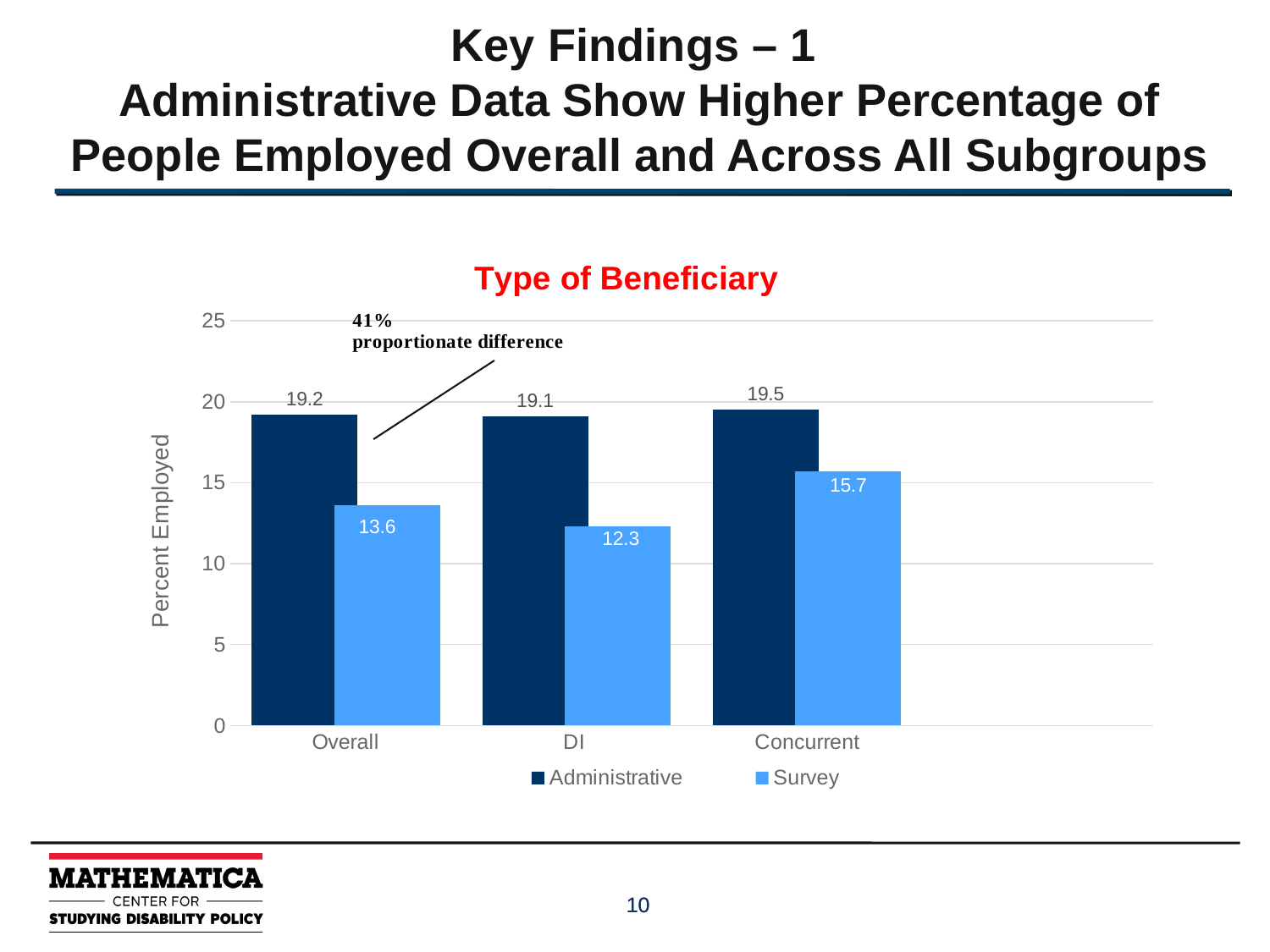
What kind of chart is shown on the slide? Bar chart How many categories are shown on the x axis? 3 Which category has the highest Administrative value? Concurrent Which is larger, the Survey value for Concurrent or the Survey value for Overall? Survey value for Concurrent What is the Survey value for Concurrent? 15.7 Which category has the lowest Survey value? DI What is the difference between the Administrative and Survey values for DI? 6.8 What is the difference between the Administrative and Survey values for Overall? 5.6 What is the label on the vertical axis? Percent Employed What is the Administrative value for Overall? 19.2 How many series does the legend list? 2 What is the Survey value for DI? 12.3